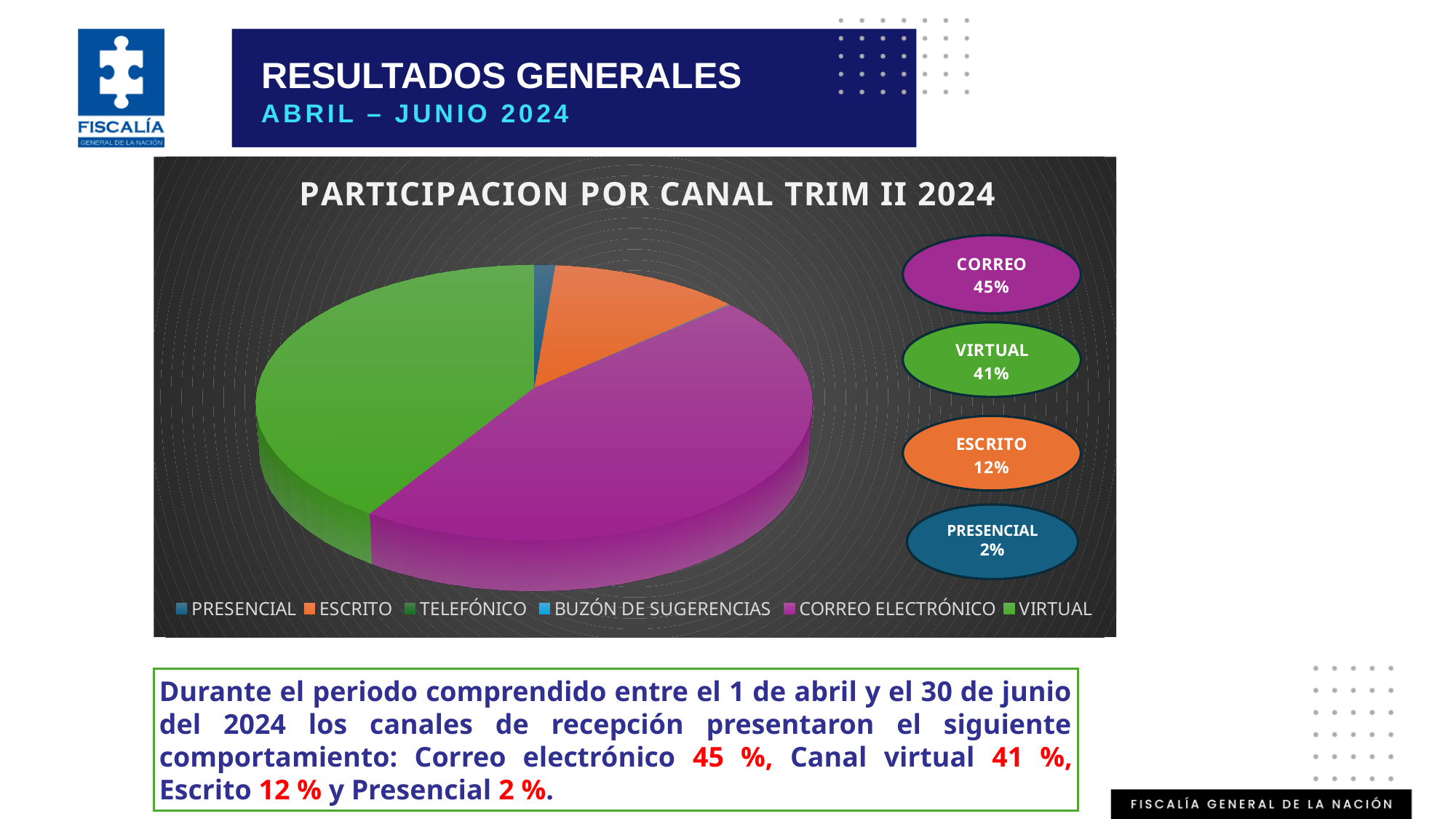
Which channel has the largest share in the chart? CORREO (correo electrónico) What share does CORREO (correo electrónico) have in the chart? 45% What colour is the CORREO ELECTRÓNICO slice in the pie chart? Purple (magenta) What share does the PRESENCIAL channel have? 2% What is the title of the chart? PARTICIPACION POR CANAL TRIM II 2024 What is the difference in percentage points between the CORREO and VIRTUAL shares? 4 percentage points Which of the labelled channels has the smallest share? PRESENCIAL How many entries does the chart legend list? 6 What type of chart is shown on the slide? Pie chart Which has a larger share, ESCRITO or PRESENCIAL? ESCRITO What share does the VIRTUAL channel have? 41% What share does the ESCRITO channel have? 12%